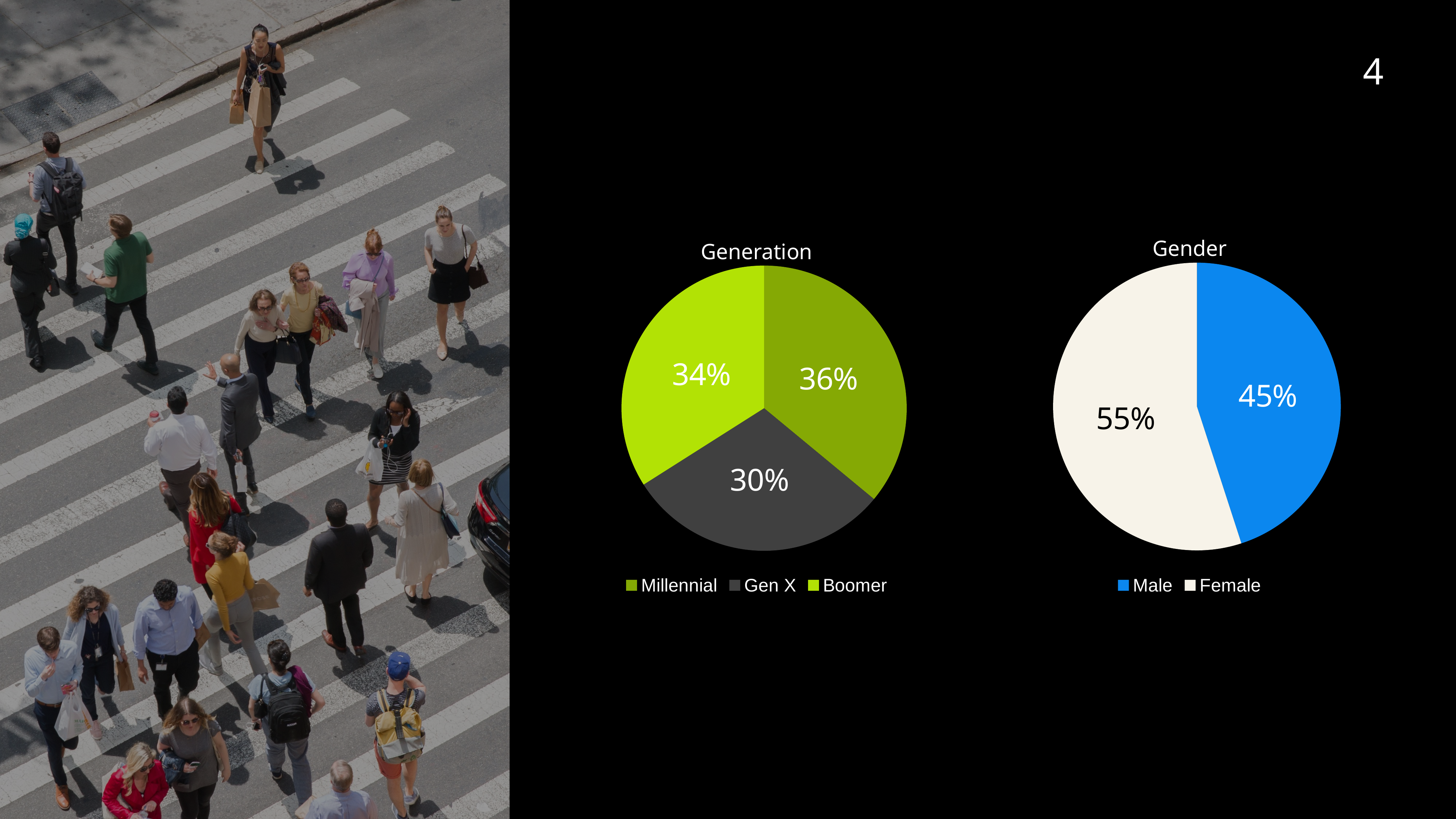
What type of chart is the Gender chart? Pie chart In the Generation chart, what percentage is Boomer? 34% In the Generation chart, what percentage is Millennial? 36% In the Generation chart, which generation has the smallest share? Gen X In the Generation chart, which generation has the largest share? Millennial In the Gender chart, what is the difference between the Female and Male shares? 10% In the Generation chart, what is the difference between the Millennial and Gen X shares? 6% In the Generation chart, what percentage is Gen X? 30% In the Generation chart, how many categories are shown? 3 In the Gender chart, what percentage is Male? 45% In the Gender chart, what percentage is Female? 55% In the Gender chart, which is larger, Male or Female? Female